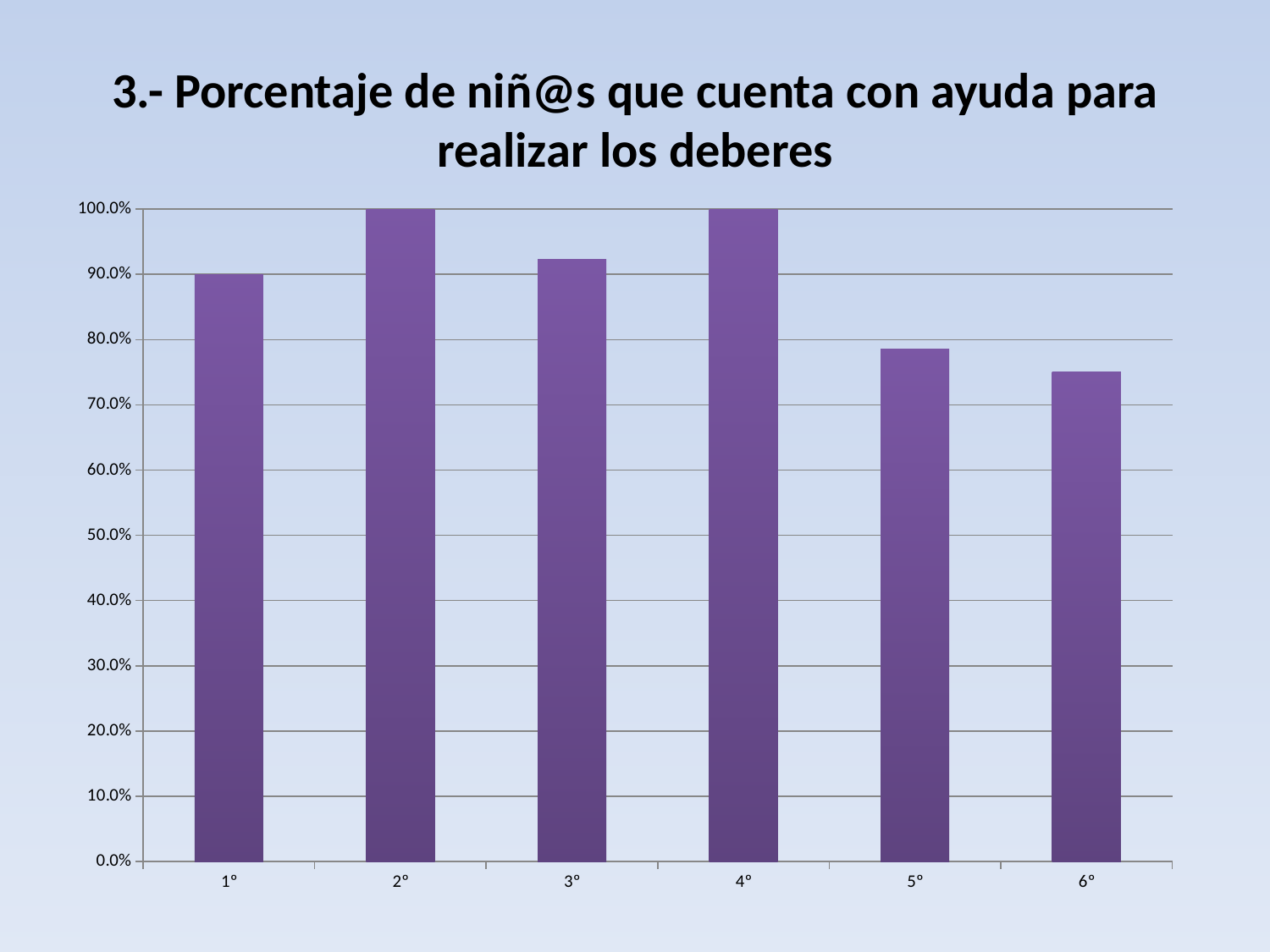
Is the value for 5° greater or less than 80.0%? less How many categories are shown on the x axis of the chart? 6 Is the value for 6° greater or less than 70.0%? greater Do the values rise or fall from 4° to 6° along the x axis? fall What is the value for 4° in the chart? 100.0% What is the difference between the values for 2° and 1°? 10.0% What is the value for 1° in the chart? 90.0% What is the title of the chart on the slide? 3.- Porcentaje de niñ@s que cuenta con ayuda para realizar los deberes What kind of chart is shown on the slide? bar chart Which has a larger value, 3° or 5°? 3° What is the value for 2° in the chart? 100.0% Which category has the lowest value in the chart? 6°